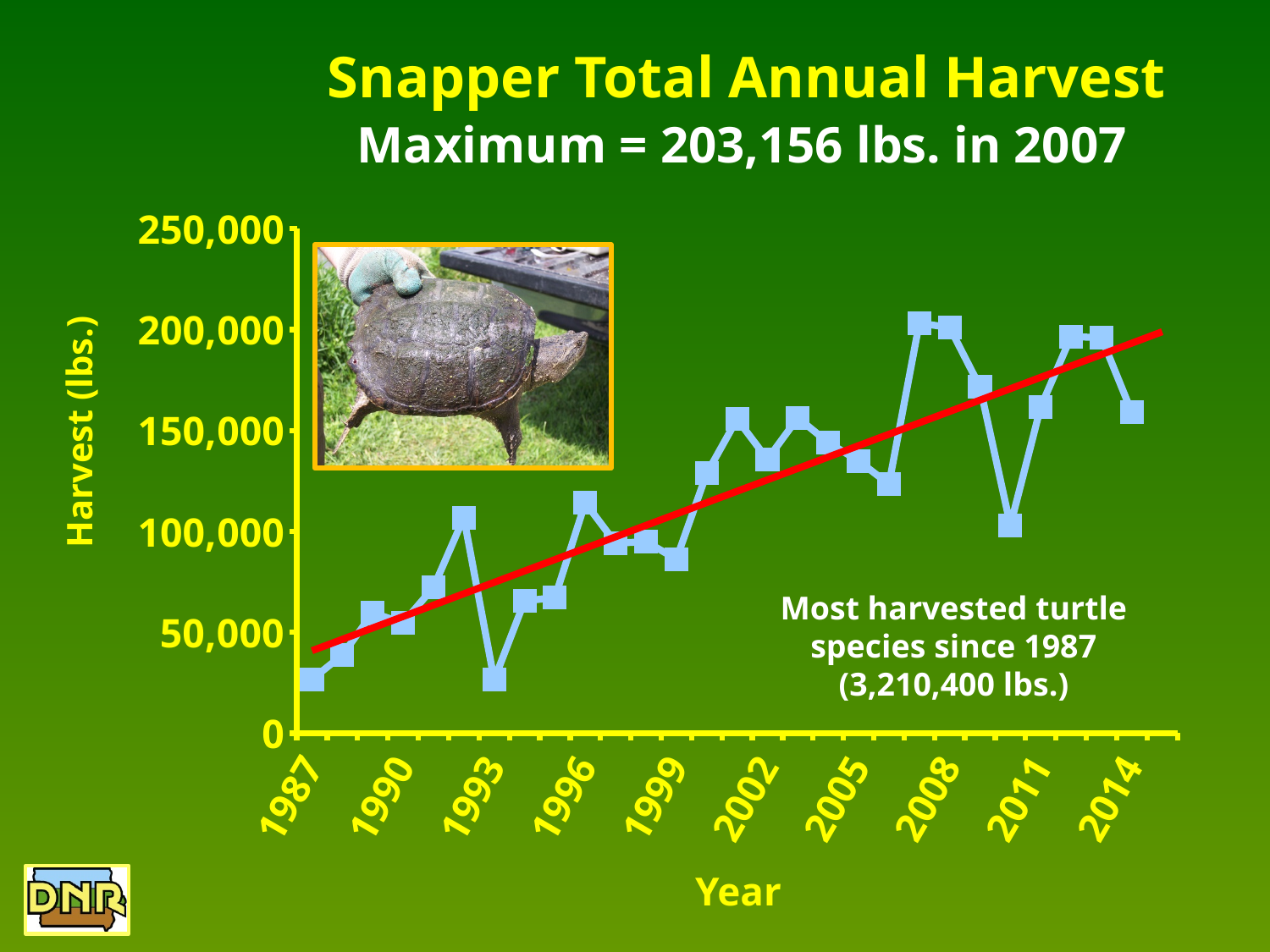
Is the harvest value for 2006 greater or less than 150,000? less What type of chart is shown on the slide? line chart Is the harvest value for 1993 greater or less than 50,000? less Which year had the larger harvest, 1992 or 1993? 1992 What was the maximum annual snapper harvest shown on the slide? 203,156 lbs. Is the harvest value for 2007 greater or less than 200,000? greater In which year was the maximum snapper harvest recorded? 2007 What is the label on the vertical axis of the chart? Harvest (lbs.) Which year had the larger harvest, 2009 or 2010? 2009 Overall, does the snapper harvest rise or fall from 1987 to 2014? rise